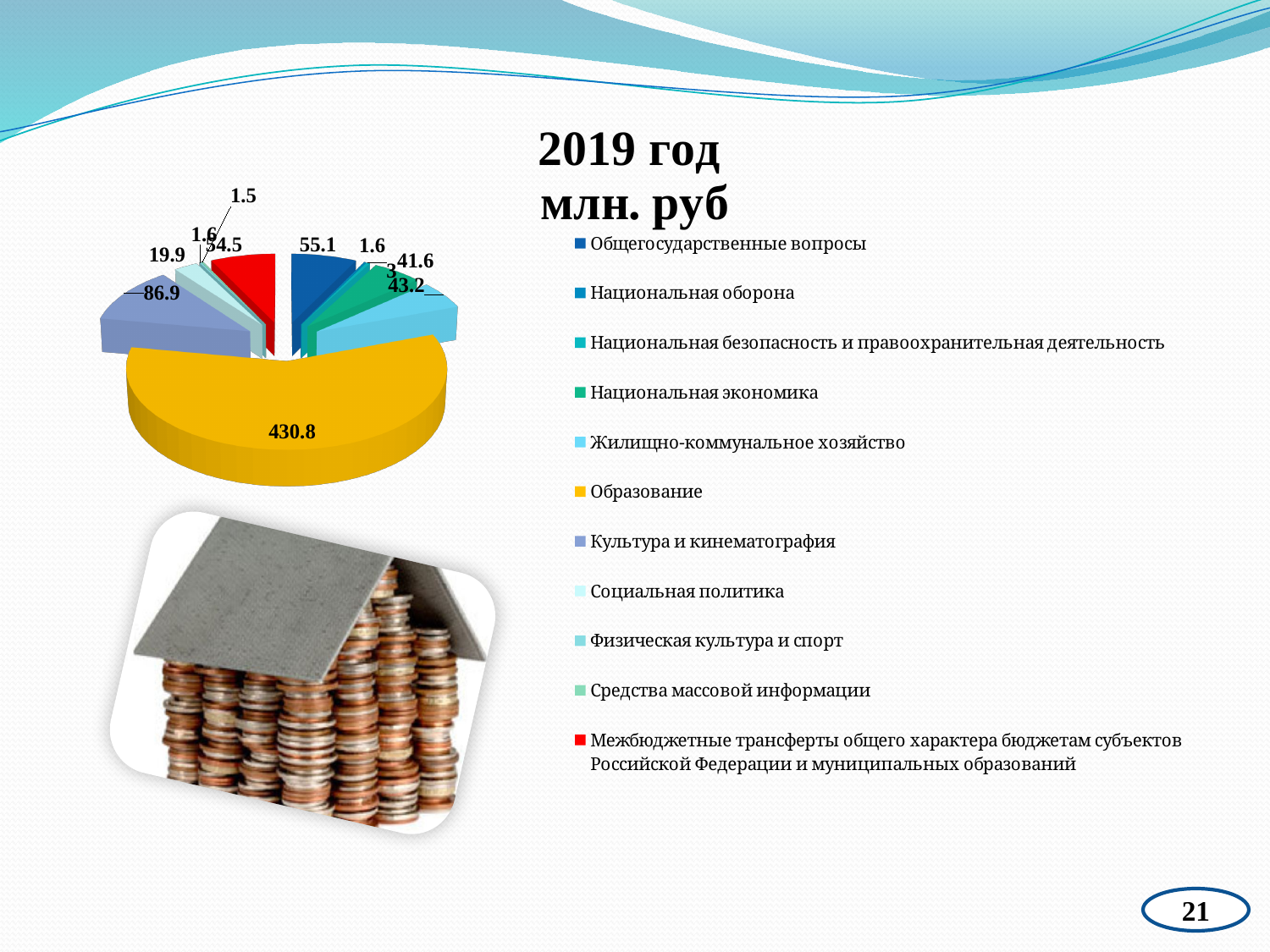
Which is larger, the value for Культура и кинематография or the value for Общегосударственные вопросы? Культура и кинематография What is the value for Культура и кинематография in the pie chart? 86.9 What kind of chart is shown on the slide? pie chart What is the value for Национальная экономика in the pie chart? 41.6 What colour is the slice for Образование? yellow Which category has the largest slice in the pie chart? Образование How many categories does the legend of the pie chart list? 11 What year and unit does the chart title state? 2019 год, млн. руб What is the difference between the values for Образование and Культура и кинематография? 343.9 What is the value for Жилищно-коммунальное хозяйство in the pie chart? 43.2 What is the value for Образование in the pie chart? 430.8 What is the value for Общегосударственные вопросы in the pie chart? 55.1